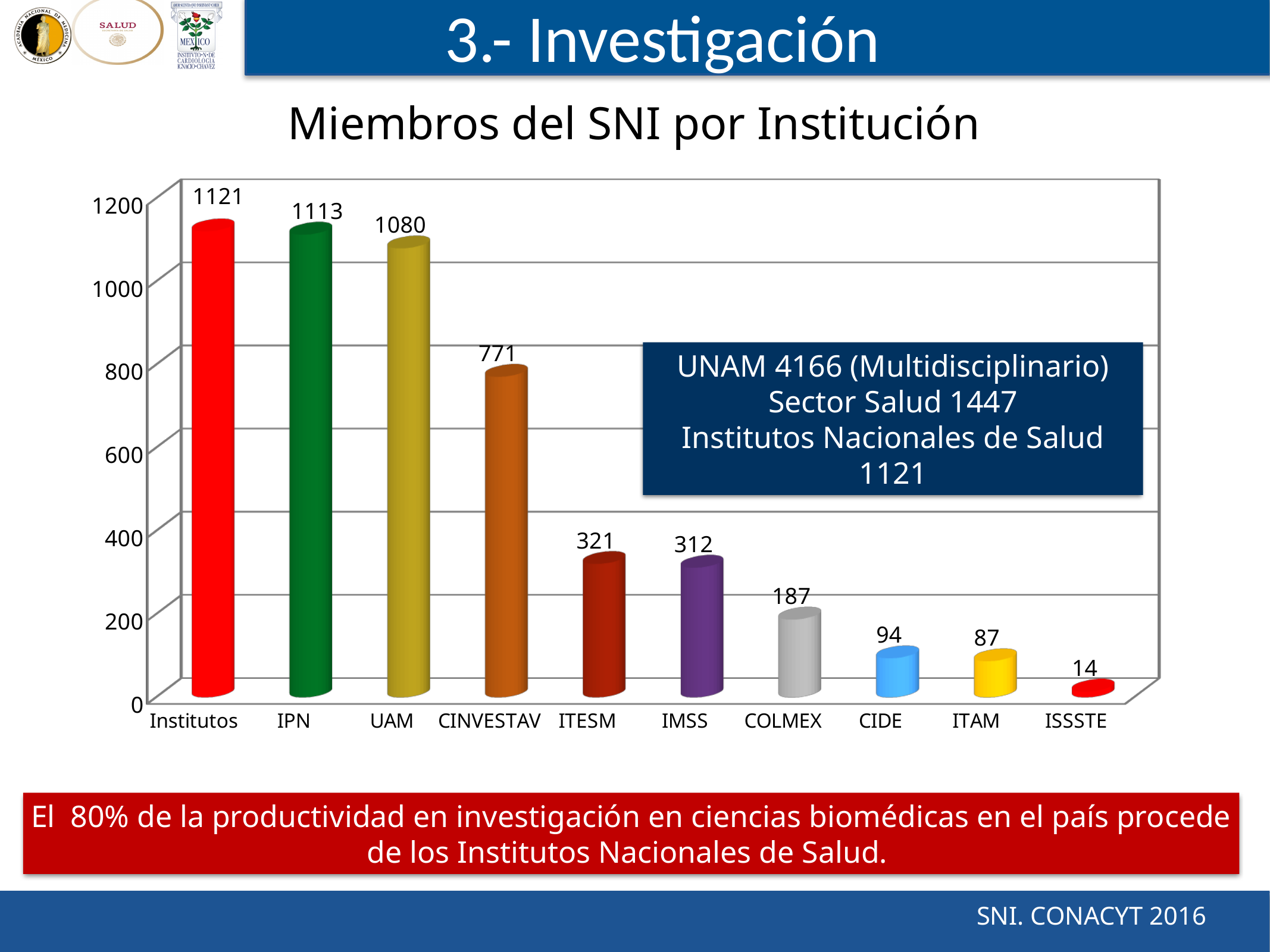
What is the value for CINVESTAV? 771 What is the value for IPN? 1113 Is the value for CIDE greater or less than 200? less What is the title of the chart? Miembros del SNI por Institución Which is larger, the value for UAM or the value for CINVESTAV? UAM What is the value for COLMEX? 187 How many institutions are shown on the x axis? 10 What kind of chart is shown on the slide? bar chart What is the difference between the values for Institutos and IPN? 8 Which institution has the highest value? Institutos Which institution has the lowest value? ISSSTE What is the difference between the values for ITESM and IMSS? 9